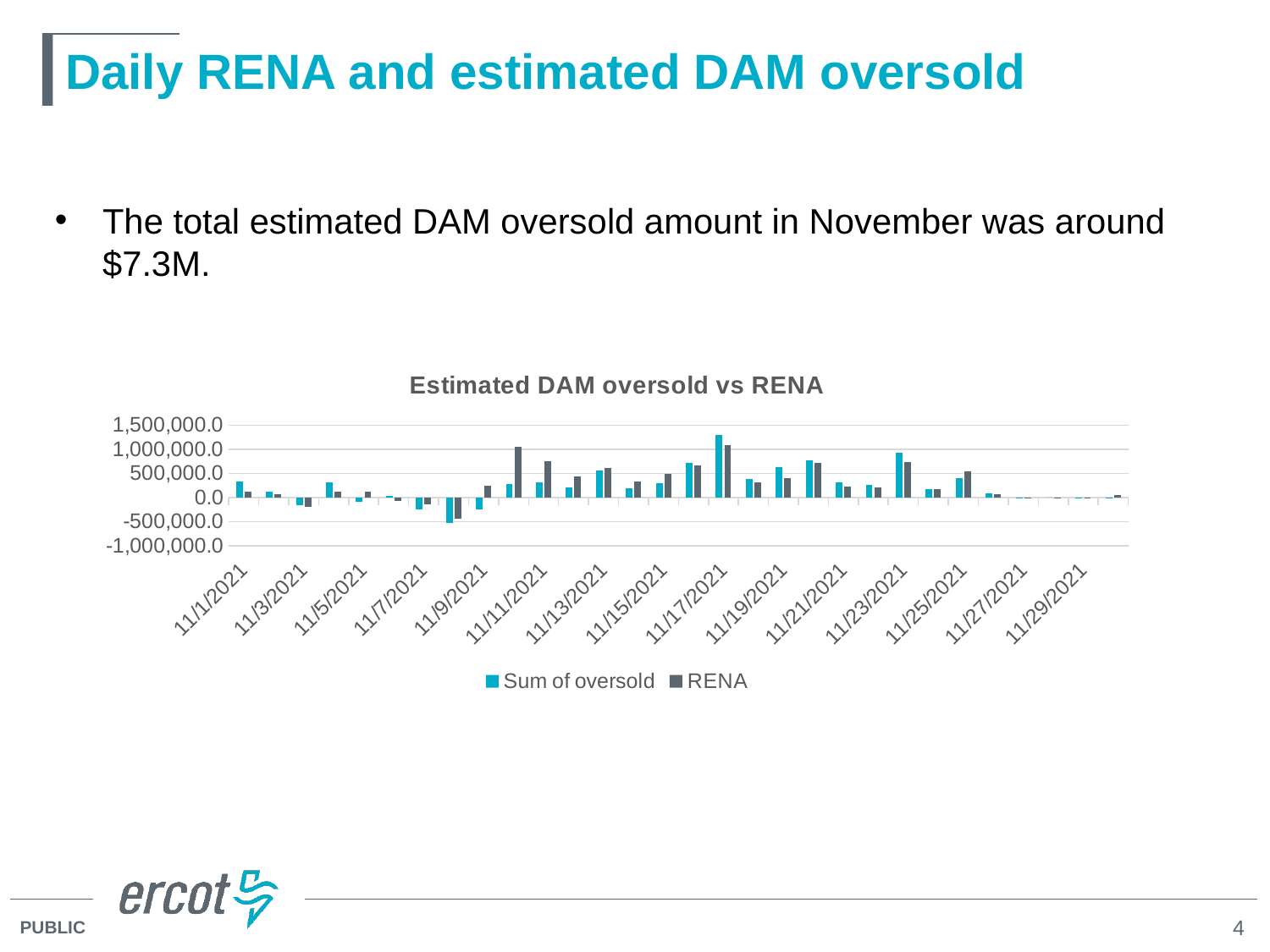
What type of chart is shown on the slide? bar chart Is the Sum of oversold value for 11/1/2021 greater or less than 500,000.0? less What is the title of the chart? Estimated DAM oversold vs RENA What are the two series named in the chart legend? Sum of oversold and RENA On 11/23/2021, which is larger: Sum of oversold or RENA? Sum of oversold How many series does the legend of the chart list? 2 What is the highest value shown on the y axis of the chart? 1,500,000.0 Is the RENA value for 11/17/2021 greater or less than 500,000.0? greater On which date is the Sum of oversold value highest? 11/17/2021 Is the Sum of oversold value for 11/29/2021 greater or less than 500,000.0? less